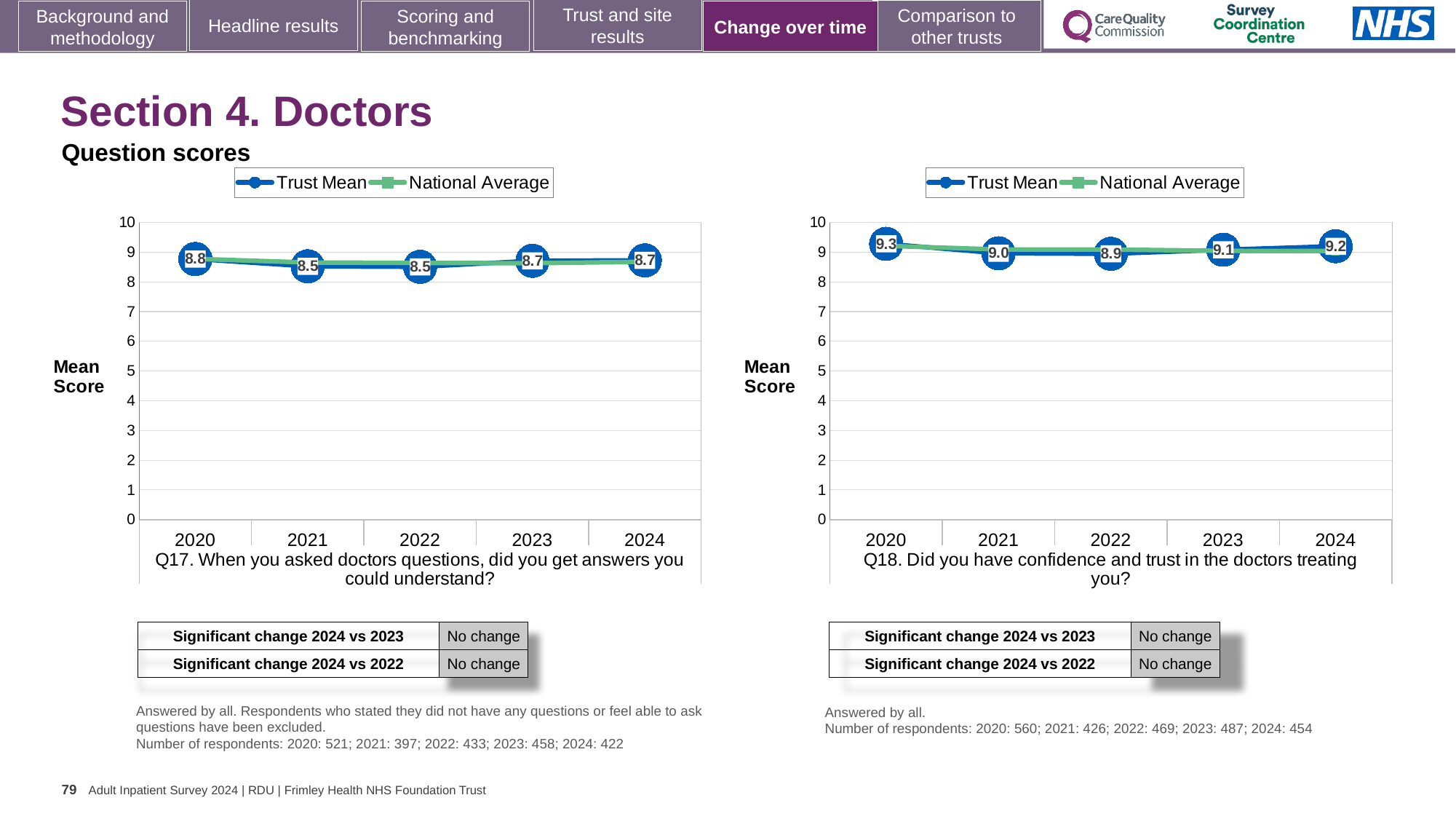
On the Q18 chart (right), what is the Trust Mean score for 2022? 8.9 How many years are plotted on the Q17 chart (left)? 5 On the Q18 chart (right), what is the difference between the Trust Mean scores for 2020 and 2022? 0.4 On the Q17 chart (left), is the Trust Mean score for 2020 greater or less than 8? greater On the Q17 chart (left), what is the difference between the Trust Mean scores for 2020 and 2021? 0.3 On the Q18 chart (right), which year has the highest Trust Mean score? 2020 On the Q18 chart (right), which year has the lowest Trust Mean score? 2022 On the Q18 chart (right), what is the Trust Mean score for 2024? 9.2 How many series does the legend of the Q18 chart (right) list? 2 On the Q17 chart (left), what is the Trust Mean score for 2020? 8.8 What type of chart is used for Q17 (left)? Line chart On the Q17 chart (left), what is the Trust Mean score for 2024? 8.7